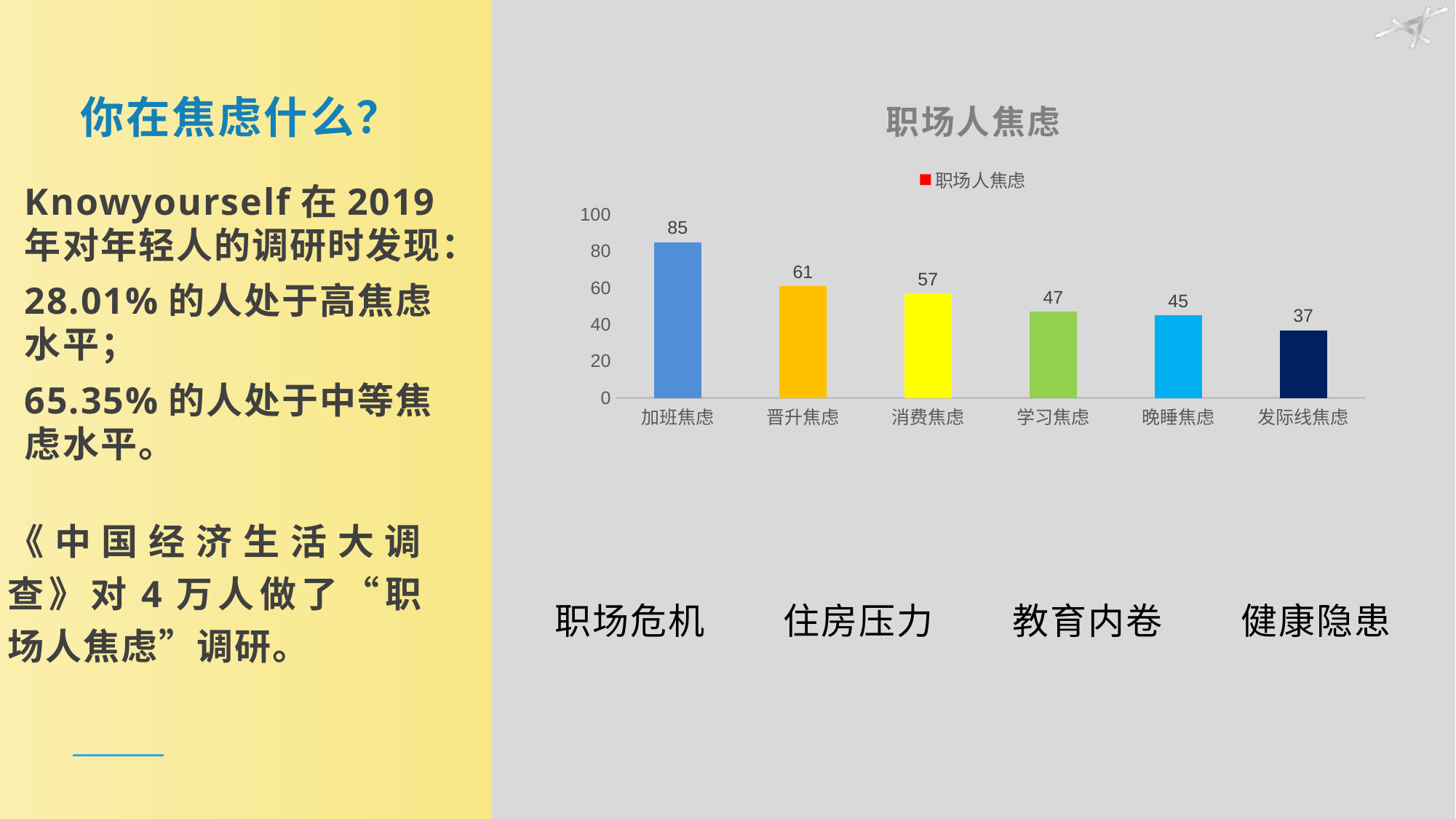
Which is larger, the value for 消费焦虑 or the value for 学习焦虑? 消费焦虑 What is the difference between the values for 加班焦虑 and 晋升焦虑? 24 How many categories are shown in the chart? 6 What kind of chart is shown? bar chart What is the value for 晋升焦虑? 61 Which category has the highest value? 加班焦虑 How many series does the legend list? 1 Is the value for 晚睡焦虑 greater or less than 60? less What is the title of the chart? 职场人焦虑 Which category has the lowest value? 发际线焦虑 What is the value for 加班焦虑? 85 What is the value for 发际线焦虑? 37